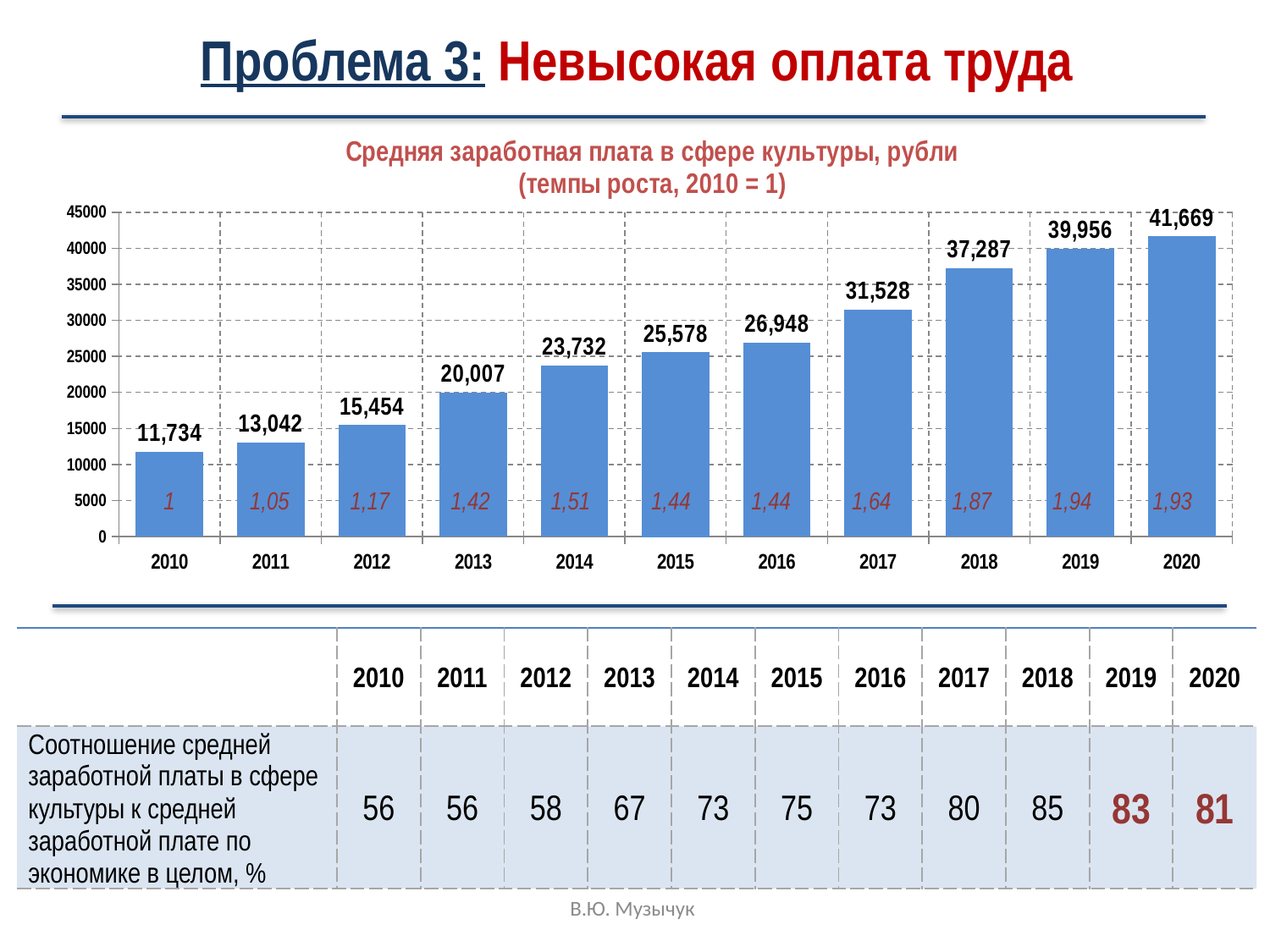
Which year has the lowest average salary? 2010 Which year has the highest average salary? 2020 Is the value for 2014 greater or less than 25000? less What growth rate (2010 = 1) is printed inside the bar for 2019? 1,94 What is the difference between the values for 2019 and 2018? 2,669 What is the average salary in the culture sector for 2015? 25,578 Do the values rise or fall from 2010 to 2020? rise How many years are shown on the x axis of the chart? 11 What is the value shown for 2018? 37,287 What is the difference between the values for 2020 and 2010? 29,935 What type of chart is shown on the slide? bar chart Which is larger, the value for 2016 or the value for 2017? 2017